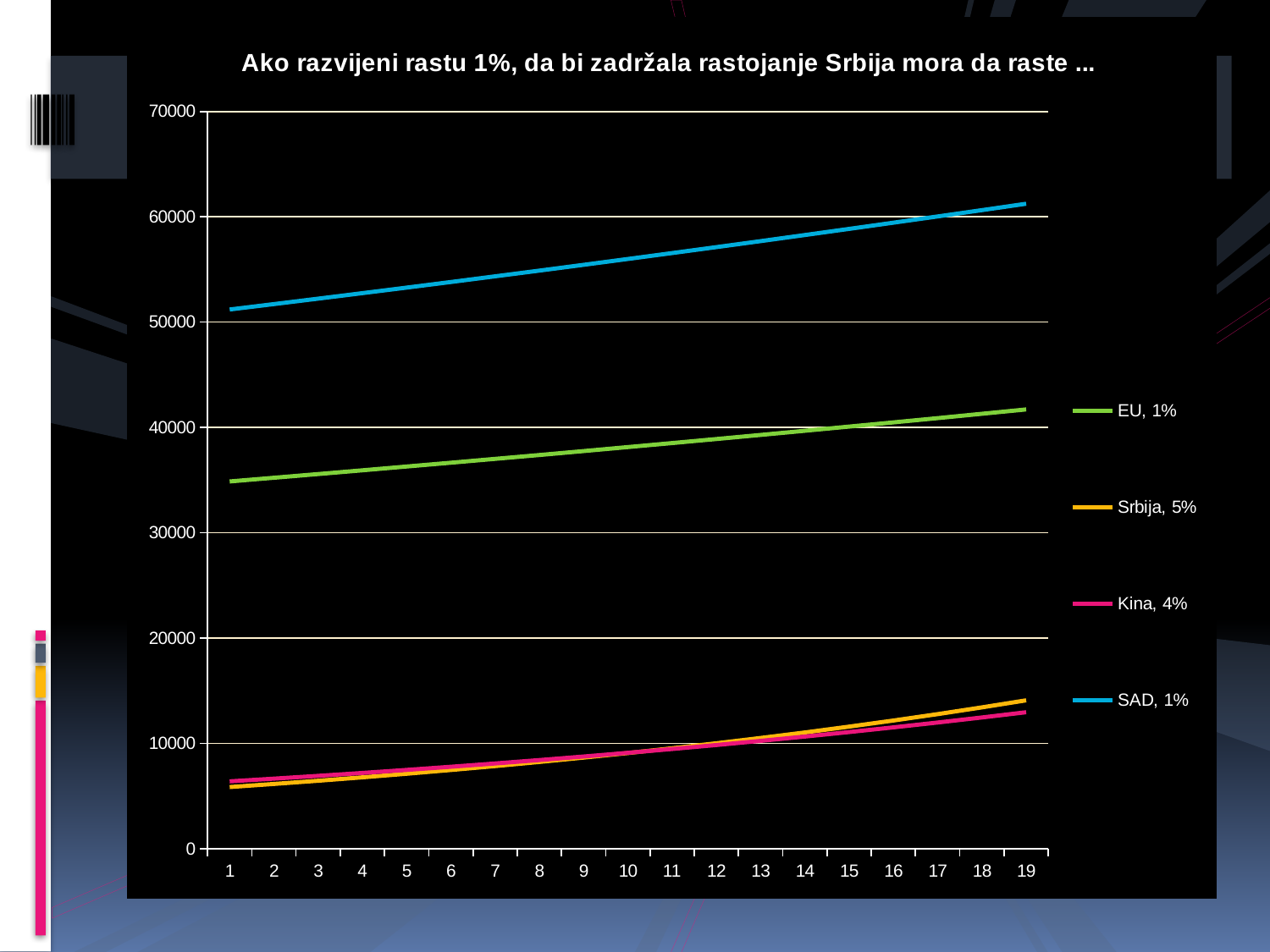
What is the title of the chart? Ako razvijeni rastu 1%, da bi zadržala rastojanje Srbija mora da raste ... Is the value for Kina, 4% at point 1 greater or less than 10000? less Which series has the lowest value at point 1? Srbija, 5% Is the value for EU, 1% at point 1 greater or less than 40000? less How many series does the legend list? 4 Which series has the highest value at point 19? SAD, 1% Do the values for Srbija, 5% rise or fall from point 1 to point 19? rise Is the value for Srbija, 5% at point 19 greater or less than 10000? greater At point 19, which is larger: Srbija, 5% or Kina, 4%? Srbija, 5% What kind of chart is shown on the slide? line chart How many points are there along the x axis? 19